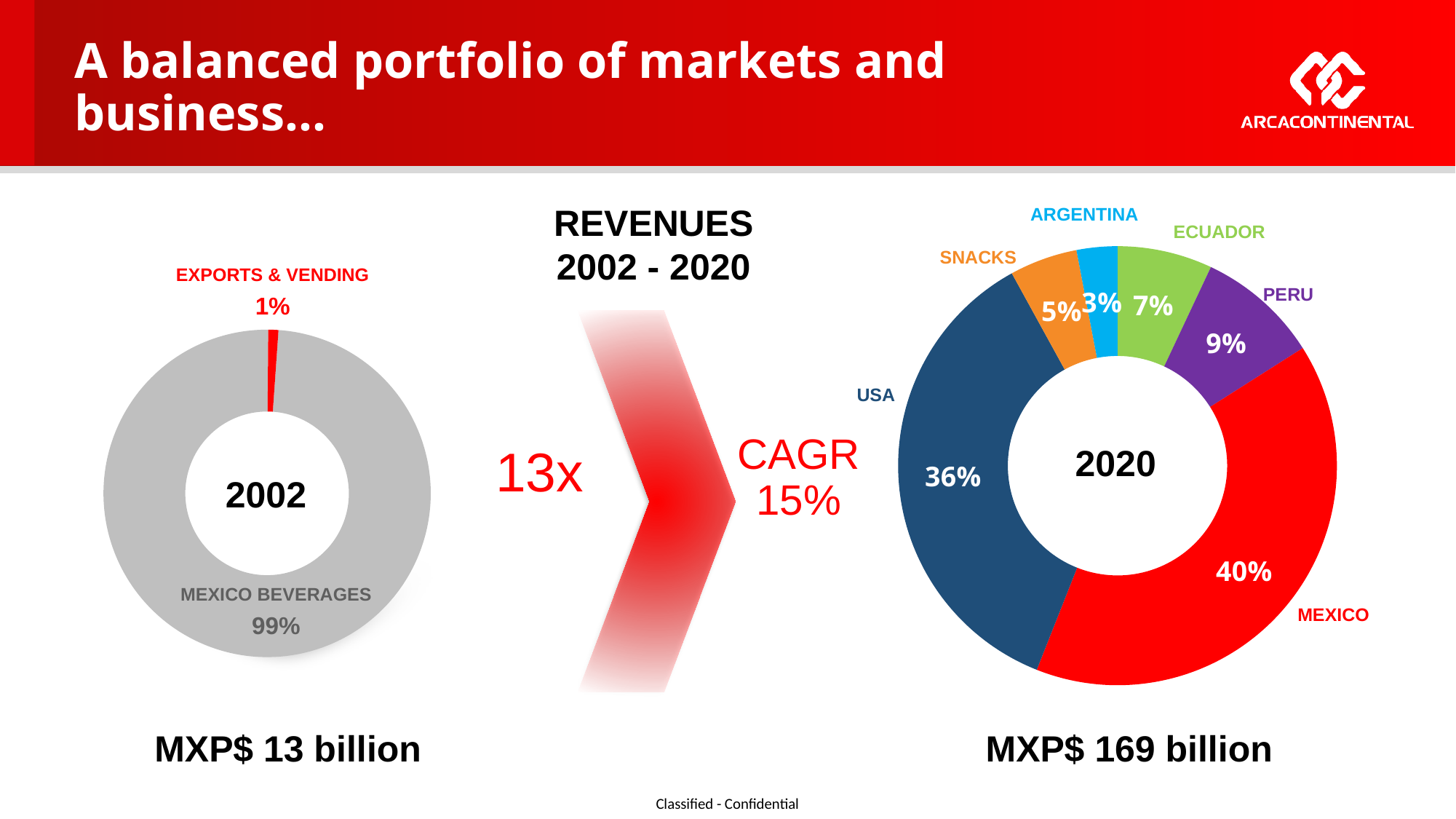
In the 2020 chart, what share of revenues came from Argentina? 3% In the 2020 chart, what share of revenues came from the USA? 36% In the 2020 chart, which category has the smallest share? Argentina In the 2020 chart, what share of revenues came from Mexico? 40% In the 2020 chart, what is the difference between the Mexico share and the USA share? 4% In the 2020 chart, what share of revenues came from Peru? 9% How many categories does the 2002 chart show? 2 In the 2002 chart, what share of revenues came from Mexico Beverages? 99% In the 2020 chart, which category has the largest share? Mexico What kind of chart is the 2002 chart? Doughnut chart In the 2002 chart, what share of revenues came from Exports & Vending? 1% How many categories does the 2020 chart show? 6